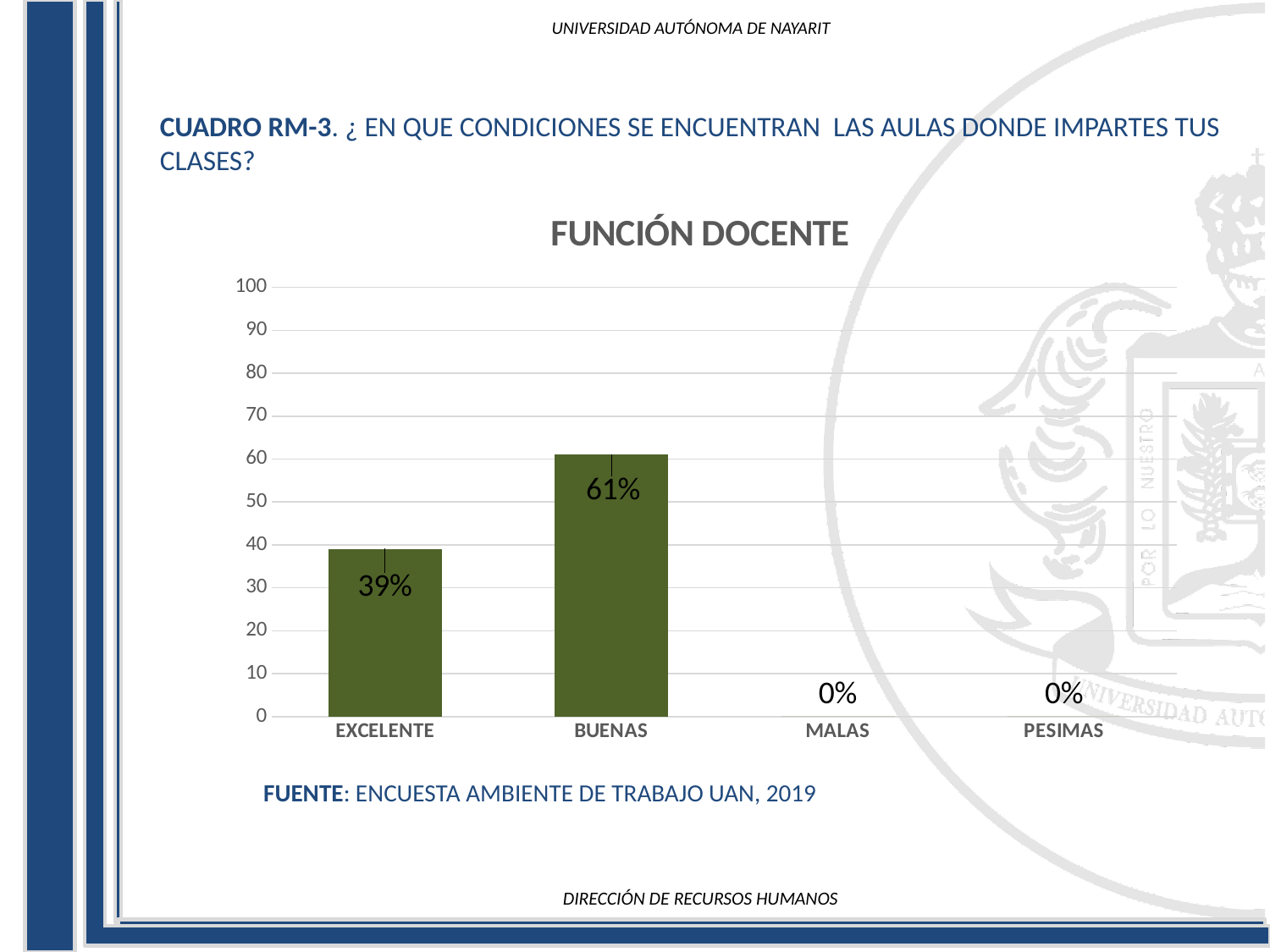
Which category has the highest value? BUENAS Which is larger, the value for EXCELENTE or the value for BUENAS? BUENAS What is the value for MALAS? 0% What is the difference between the values for BUENAS and EXCELENTE? 22% What kind of chart is shown on the slide? bar chart How many categories are shown on the x axis? 4 What is the value for BUENAS? 61% What is the title of the chart? FUNCIÓN DOCENTE What is the value for EXCELENTE? 39% Is the value for BUENAS greater or less than 50? greater What is the value for PESIMAS? 0% Is the value for EXCELENTE greater or less than 40? less